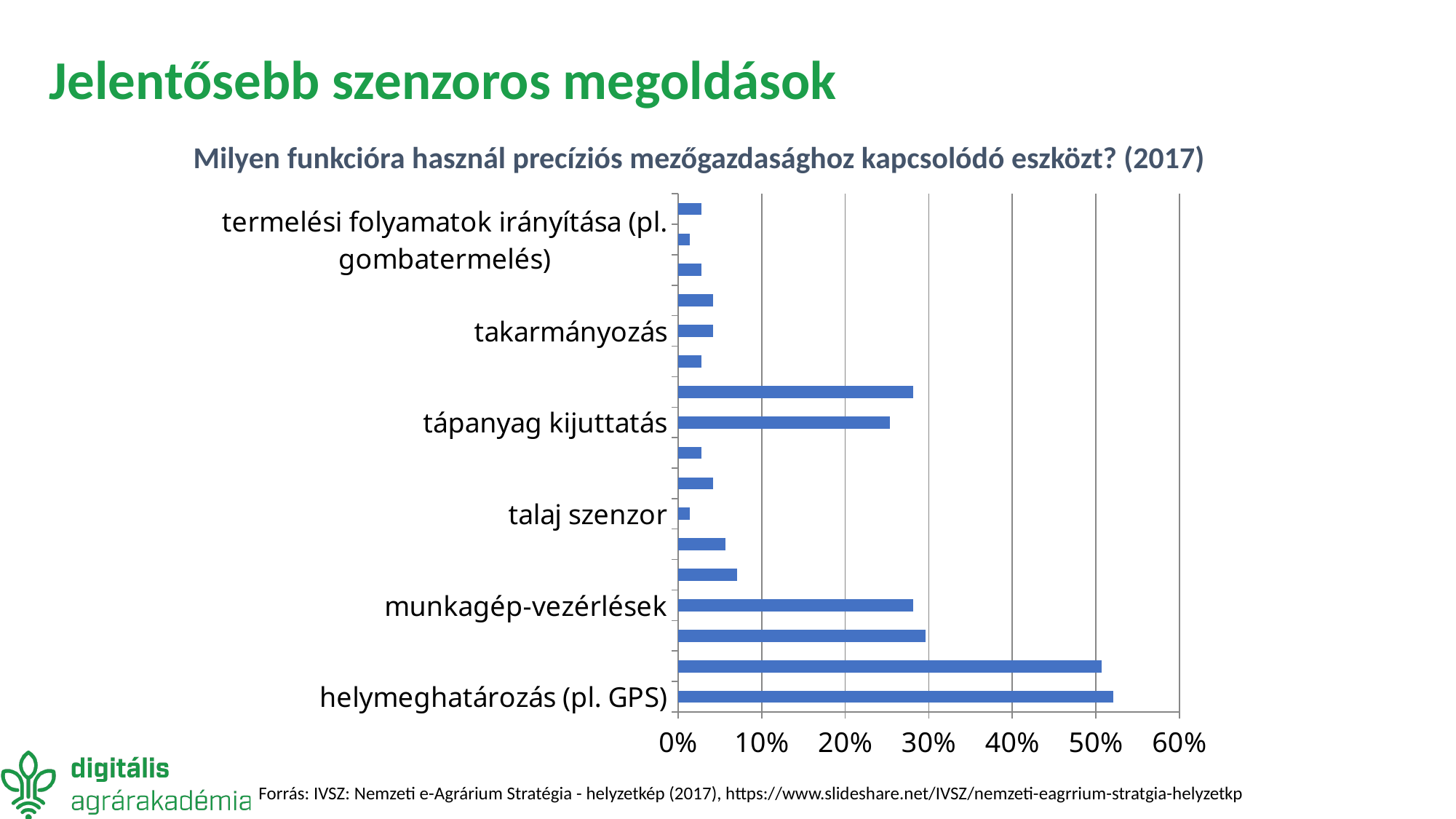
Is the value for helymeghatározás (pl. GPS) greater or less than 40%? greater Is the value for takarmányozás greater or less than 10%? less Which is larger, the value for tápanyag kijuttatás or the value for talaj szenzor? tápanyag kijuttatás Which is larger, the value for helymeghatározás (pl. GPS) or the value for takarmányozás? helymeghatározás (pl. GPS) Which labelled category has the longest bar? helymeghatározás (pl. GPS) What is the title of the chart? Milyen funkcióra használ precíziós mezőgazdasághoz kapcsolódó eszközt? (2017) How many category labels are shown on the vertical axis of the chart? 6 Is the value for talaj szenzor greater or less than 10%? less What kind of chart is shown on the slide? bar chart What is the highest value shown on the horizontal axis of the chart? 60%